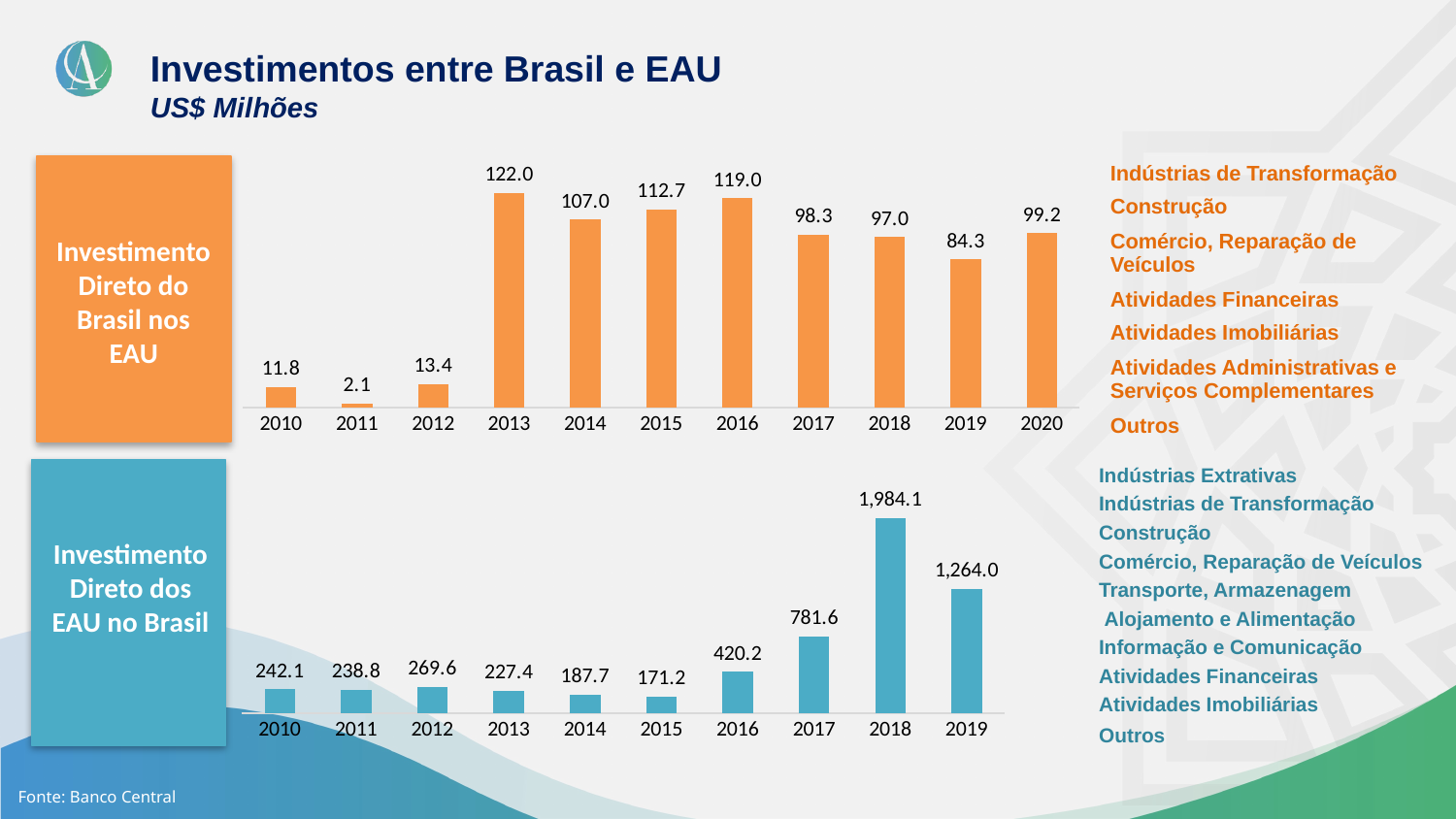
In the bottom chart (Investimento Direto dos EAU no Brasil), do the values rise or fall from 2015 to 2018? Rise In the bottom chart (Investimento Direto dos EAU no Brasil), what is the value for 2018? 1,984.1 In the top chart (Investimento Direto do Brasil nos EAU), which year has the highest value? 2013 In the bottom chart (Investimento Direto dos EAU no Brasil), which year has the lowest value? 2015 In the top chart (Investimento Direto do Brasil nos EAU), what is the value for 2013? 122.0 In the top chart (Investimento Direto do Brasil nos EAU), which year has the lowest value? 2011 In the top chart (Investimento Direto do Brasil nos EAU), how many years are shown? 11 What kind of chart is the bottom chart (Investimento Direto dos EAU no Brasil)? Bar chart In the bottom chart (Investimento Direto dos EAU no Brasil), what is the difference between the values for 2018 and 2019? 720.1 In the top chart (Investimento Direto do Brasil nos EAU), what is the difference between the values for 2016 and 2019? 34.7 In the bottom chart (Investimento Direto dos EAU no Brasil), how many years are shown? 10 In the bottom chart (Investimento Direto dos EAU no Brasil), which is larger, the value for 2017 or the value for 2019? 2019